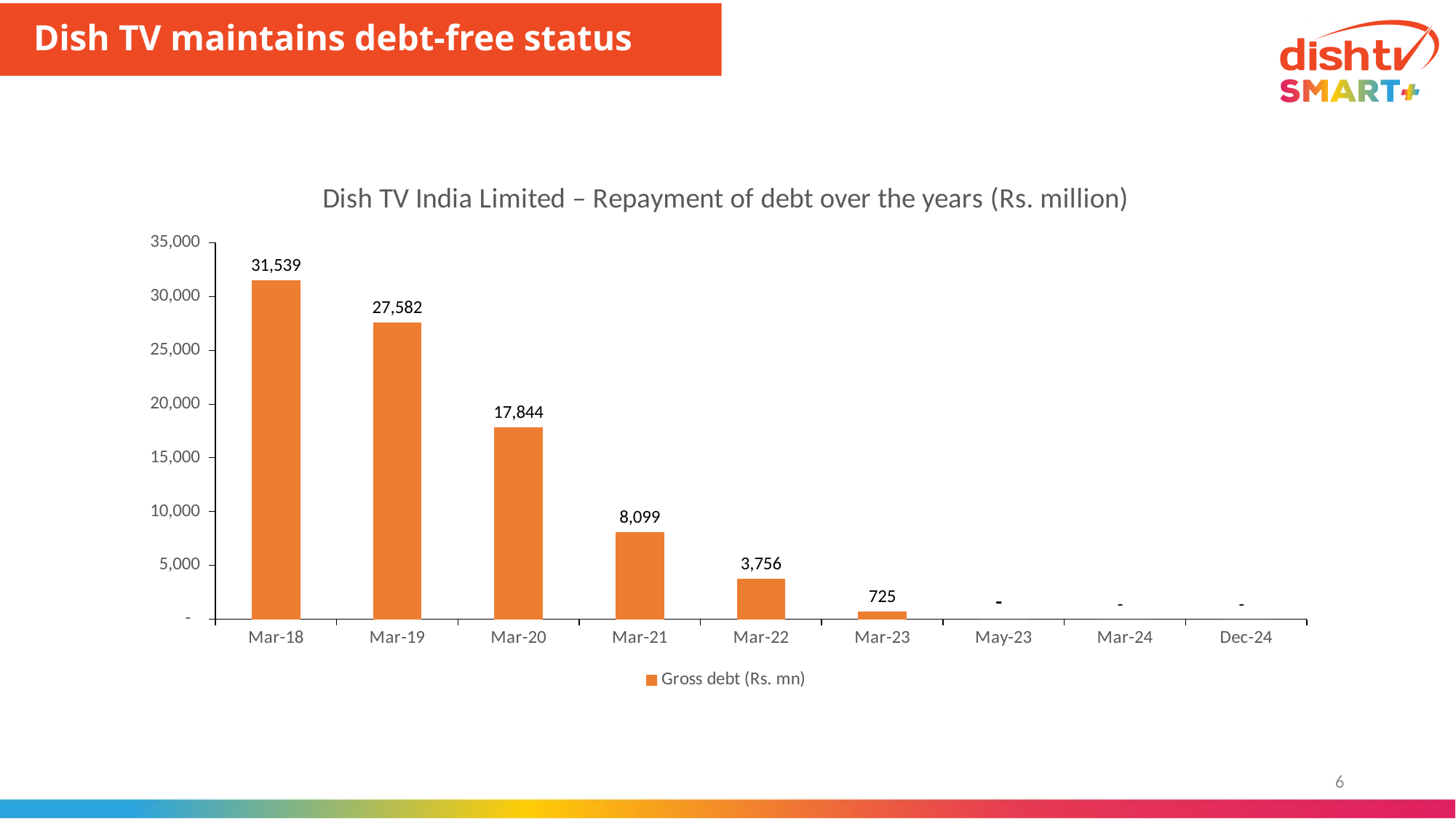
How many categories are shown on the x axis? 9 Is the gross debt for Mar-19 greater or less than 25,000? greater What is the gross debt value for Mar-21? 8,099 Which category has the highest gross debt? Mar-18 How many series does the legend list? 1 What is the gross debt value for Mar-18? 31,539 What is the difference in gross debt between Mar-18 and Mar-19? 3,957 Which is larger, the gross debt for Mar-20 or for Mar-22? Mar-20 What is the difference in gross debt between Mar-20 and Mar-21? 9,745 What is the gross debt value for Mar-23? 725 Do the gross debt values rise or fall from Mar-18 to Mar-23? Fall What kind of chart is shown on the slide? Bar chart